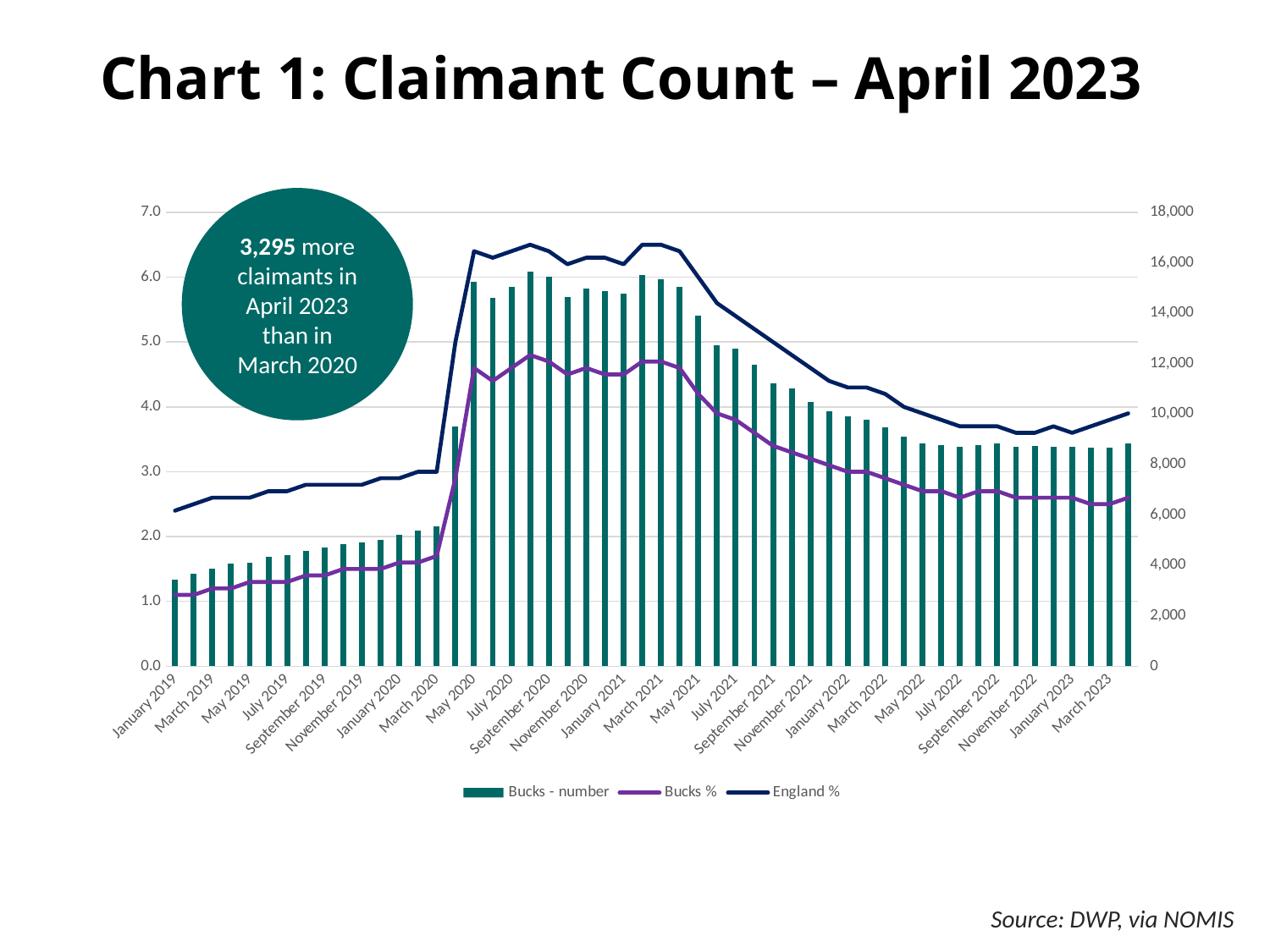
Is the Bucks % value in January 2019 greater or less than 2.0? less Do the Bucks - number bars rise or fall from May 2021 to March 2023? fall What is the title of the chart? Chart 1: Claimant Count – April 2023 Which month has the lowest Bucks - number bar? January 2019 Is the value for Bucks - number in January 2019 greater or less than 4,000? less What kind of chart is shown on the slide? A combination chart with bars and lines According to the callout on the chart, how many more claimants were there in April 2023 than in March 2020? 3,295 Is the England % value in March 2023 greater or less than 3.0? greater How many series does the legend list? 3 In March 2021, which is higher: England % or Bucks %? England %